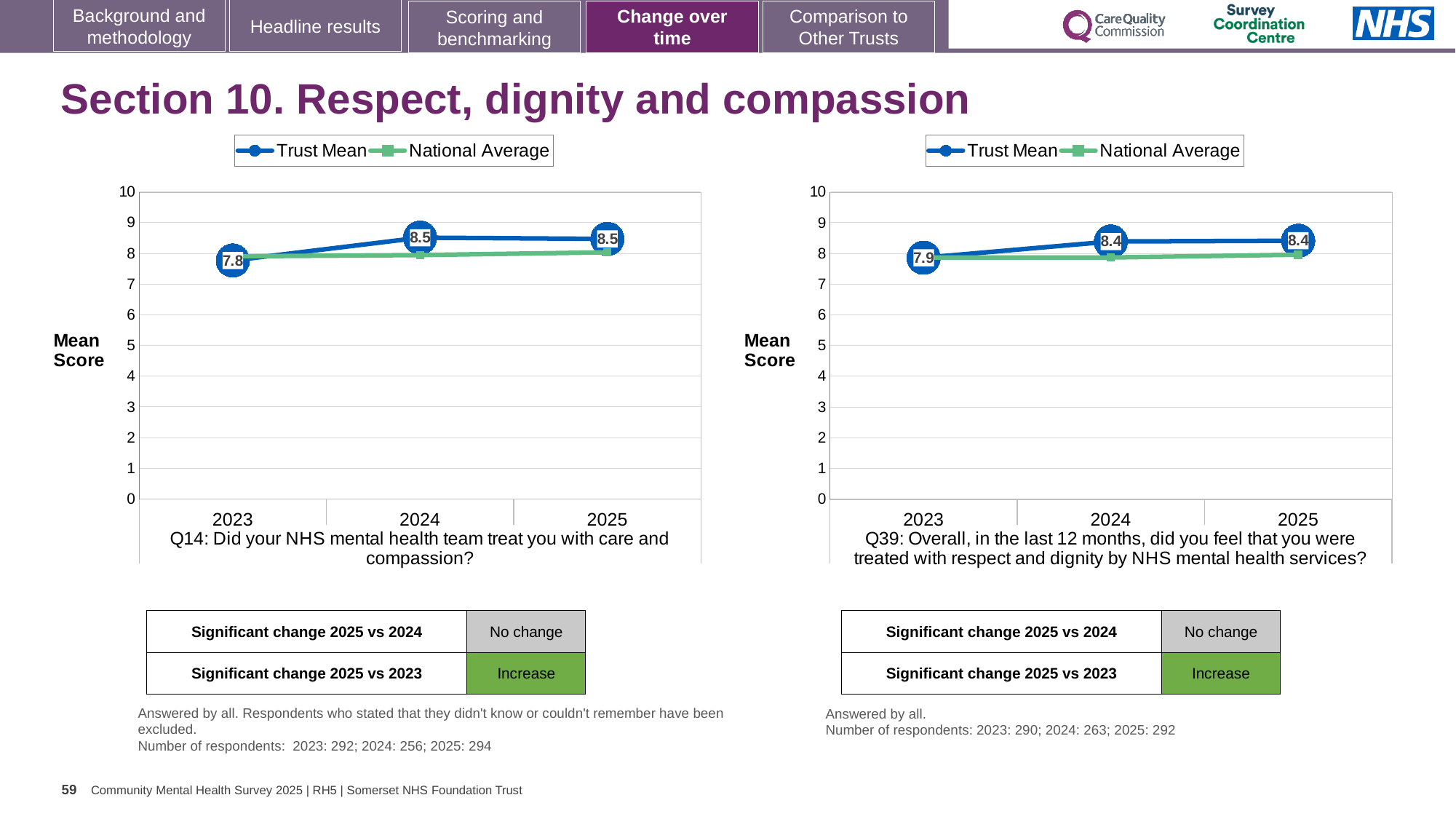
In the Q14 chart on the left, which year has the lowest Trust Mean? 2023 How many series does the legend of the Q39 chart on the right list? 2 In the Q14 chart on the left, what is the Trust Mean for 2023? 7.8 In the Q39 chart on the right, what is the difference between the Trust Mean in 2023 and in 2025? 0.5 In the Q39 chart on the right, does the Trust Mean rise or fall from 2023 to 2024? Rise In the Q39 chart on the right, what is the Trust Mean for 2024? 8.4 In the Q14 chart on the left, what is the Trust Mean for 2025? 8.5 In the Q39 chart on the right, in 2025, which is higher: the Trust Mean or the National Average? Trust Mean What kind of chart is the Q14 chart on the left? Line chart In the Q14 chart on the left, by how much did the Trust Mean change from 2023 to 2025? 0.7 In the Q39 chart on the right, what is the Trust Mean for 2023? 7.9 In the Q14 chart on the left, is the National Average for 2025 greater or less than 7? greater